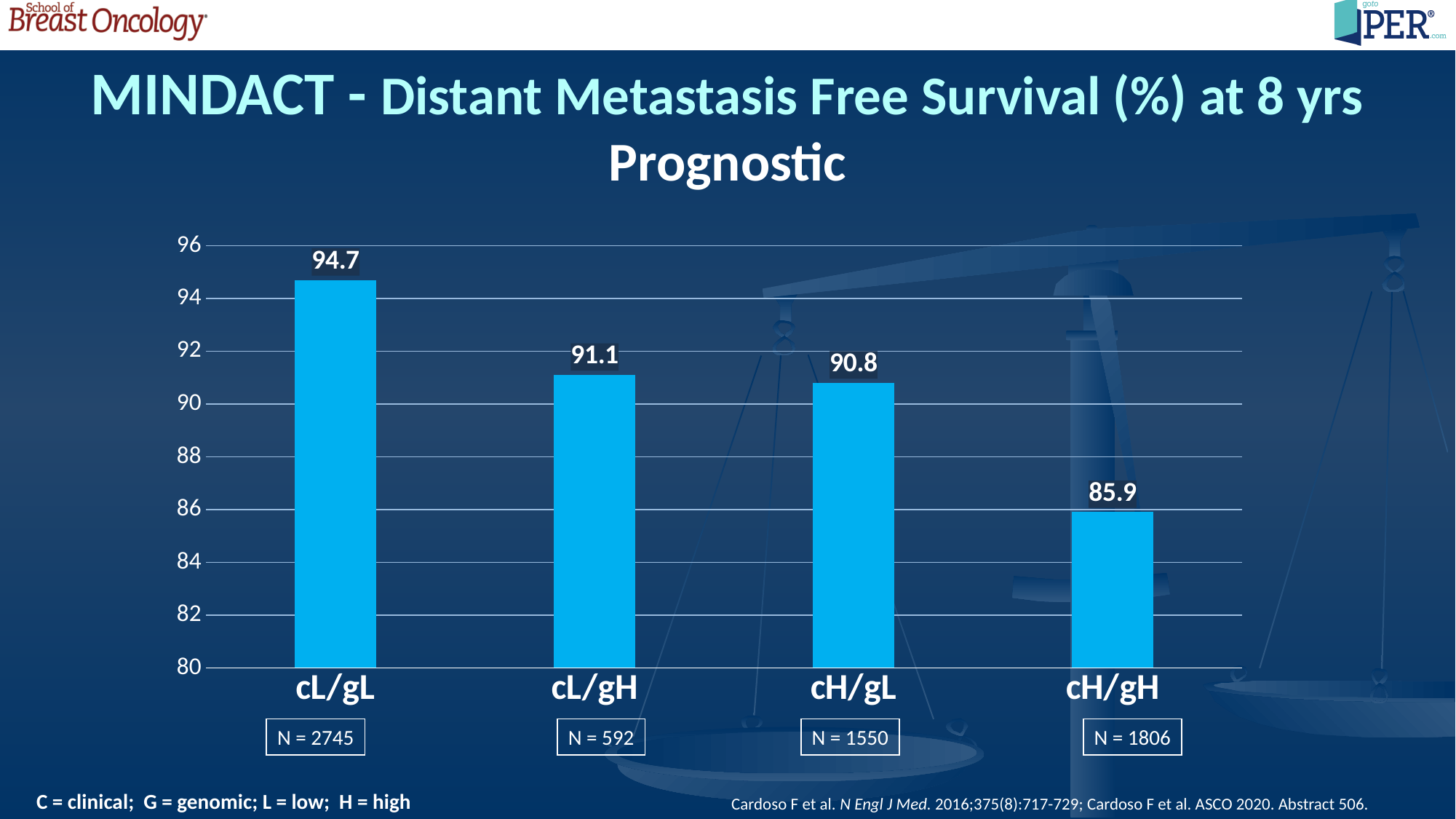
How many groups are plotted on the chart? 4 What is the value shown for the cH/gH group? 85.9 What is the difference between the values for cL/gH and cH/gL? 0.3 Which is larger, the value for cL/gH or the value for cH/gH? cL/gH What is the N shown below the cL/gH bar? N = 592 What is the distant metastasis free survival value for cL/gL? 94.7 Which group has the highest distant metastasis free survival? cL/gL Which group has the lowest distant metastasis free survival? cH/gH Is the value for cH/gH greater or less than 88? less What kind of chart is shown on the slide? bar chart What is the difference between the values for cL/gL and cH/gH? 8.8 What is the value shown for the cH/gL group? 90.8